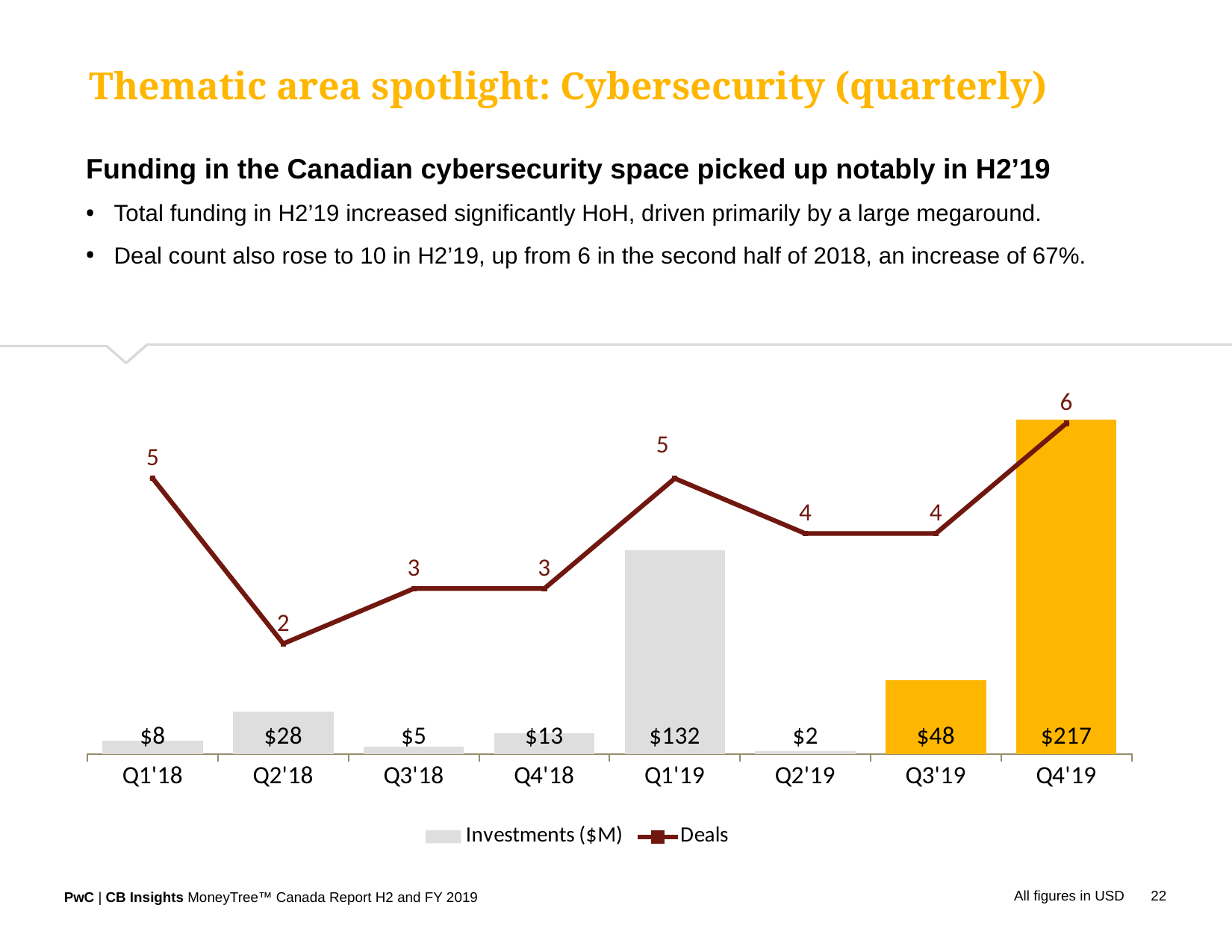
What kind of chart is used to show the Deals series? Line chart How many deals were recorded in Q4'19? 6 Which is larger, the Investments ($M) value for Q2'18 or for Q4'18? Q2'18 What is the difference in Investments ($M) between Q4'19 and Q3'19? $169 Which quarter has the lowest number of deals? Q2'18 How many more deals were there in Q4'19 than in Q2'18? 4 Which quarter has the highest Investments ($M) value? Q4'19 How many quarters are shown on the x axis? 8 What is the Investments ($M) value for Q3'19? $48 How many series does the legend list? 2 What is the Investments ($M) value for Q1'19? $132 Which quarter has the lowest Investments ($M) value? Q2'19